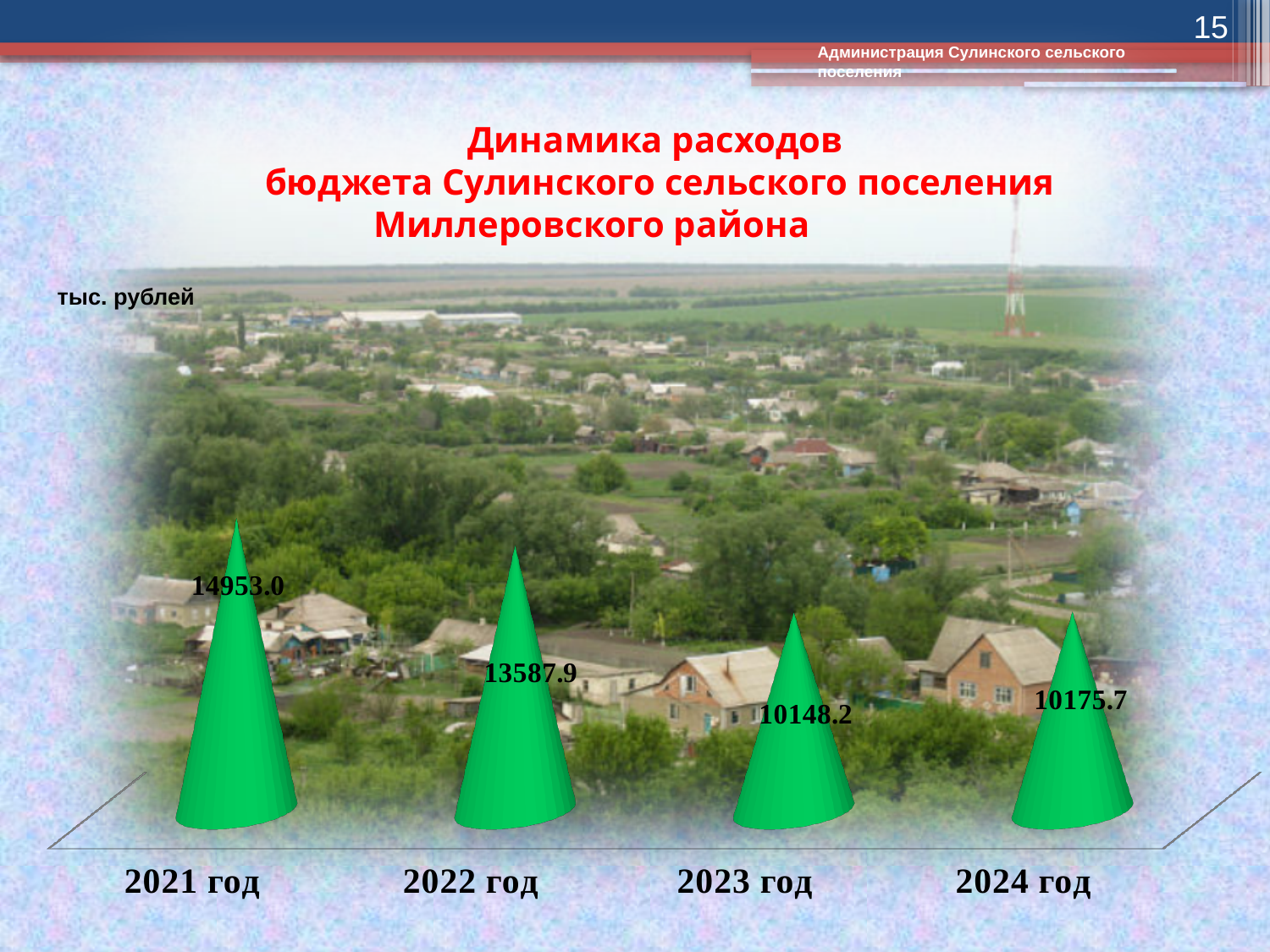
What is the value for 2021 год? 14953.0 How many years are shown on the chart? 4 What is the difference between the values for 2021 год and 2022 год? 1365.1 What is the difference between the values for 2024 год and 2023 год? 27.5 Which year has the highest value? 2021 год Do the values rise or fall from 2021 год to 2023 год? fall What is the value for 2023 год? 10148.2 What unit of measurement is indicated for the chart values? тыс. рублей Which is larger, the value for 2022 год or the value for 2024 год? 2022 год What is the value for 2024 год? 10175.7 Which year has the lowest value? 2023 год What is the value for 2022 год? 13587.9